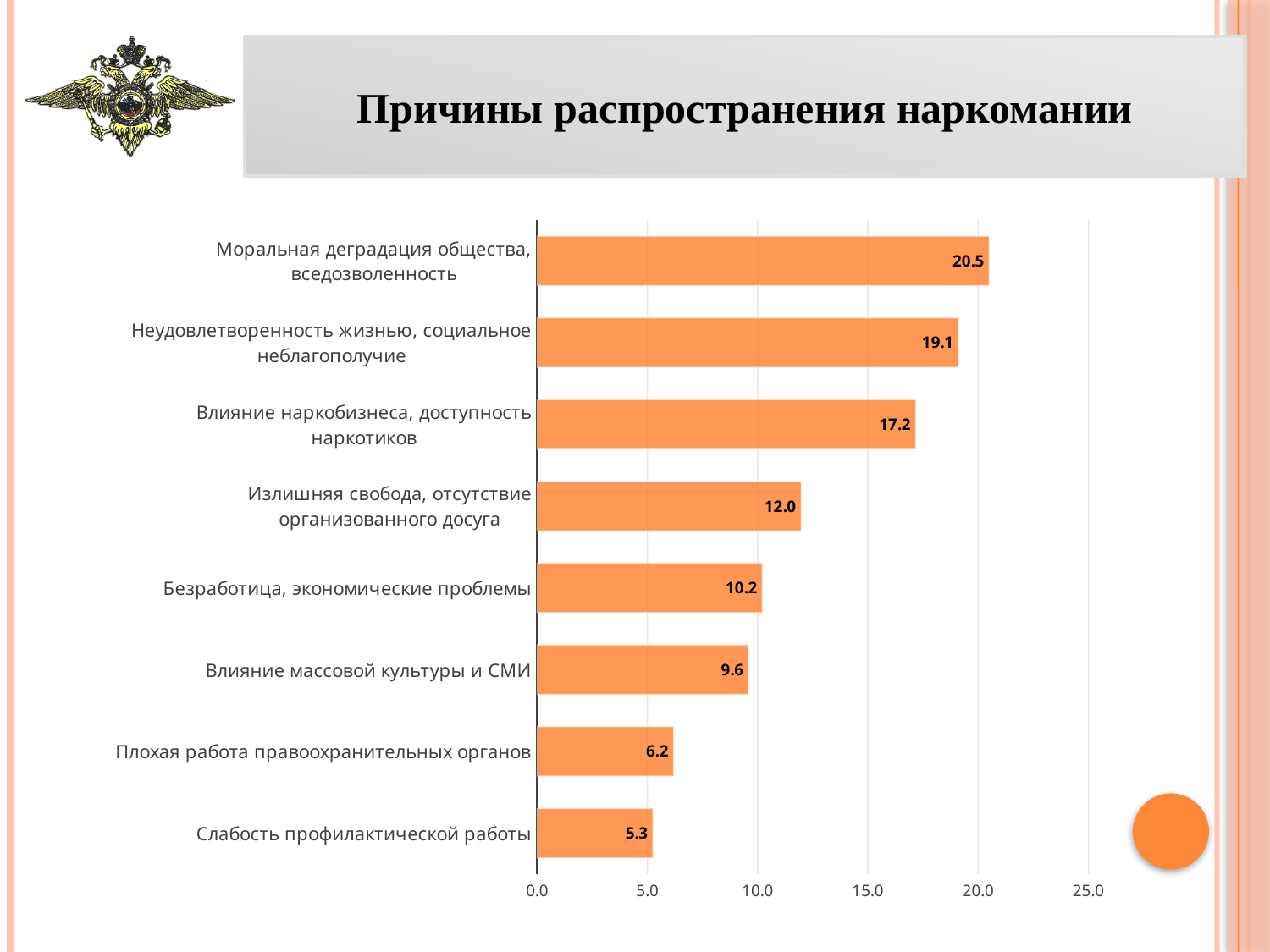
What is the difference between the values for «Неудовлетворенность жизнью, социальное неблагополучие» and «Влияние наркобизнеса, доступность наркотиков»? 1.9 What is the difference between the highest and lowest values in the chart? 15.2 Which category has the lowest value? Слабость профилактической работы Which is larger: the value for «Излишняя свобода, отсутствие организованного досуга» or for «Влияние массовой культуры и СМИ»? Излишняя свобода, отсутствие организованного досуга What is the value for «Плохая работа правоохранительных органов»? 6.2 What is the value for «Моральная деградация общества, вседозволенность»? 20.5 Is the value for «Влияние наркобизнеса, доступность наркотиков» greater or less than 15.0? greater Which category has the highest value? Моральная деградация общества, вседозволенность What is the value for «Безработица, экономические проблемы»? 10.2 What is the title of the slide? Причины распространения наркомании What kind of chart is shown on the slide? bar chart How many categories are shown in the chart? 8